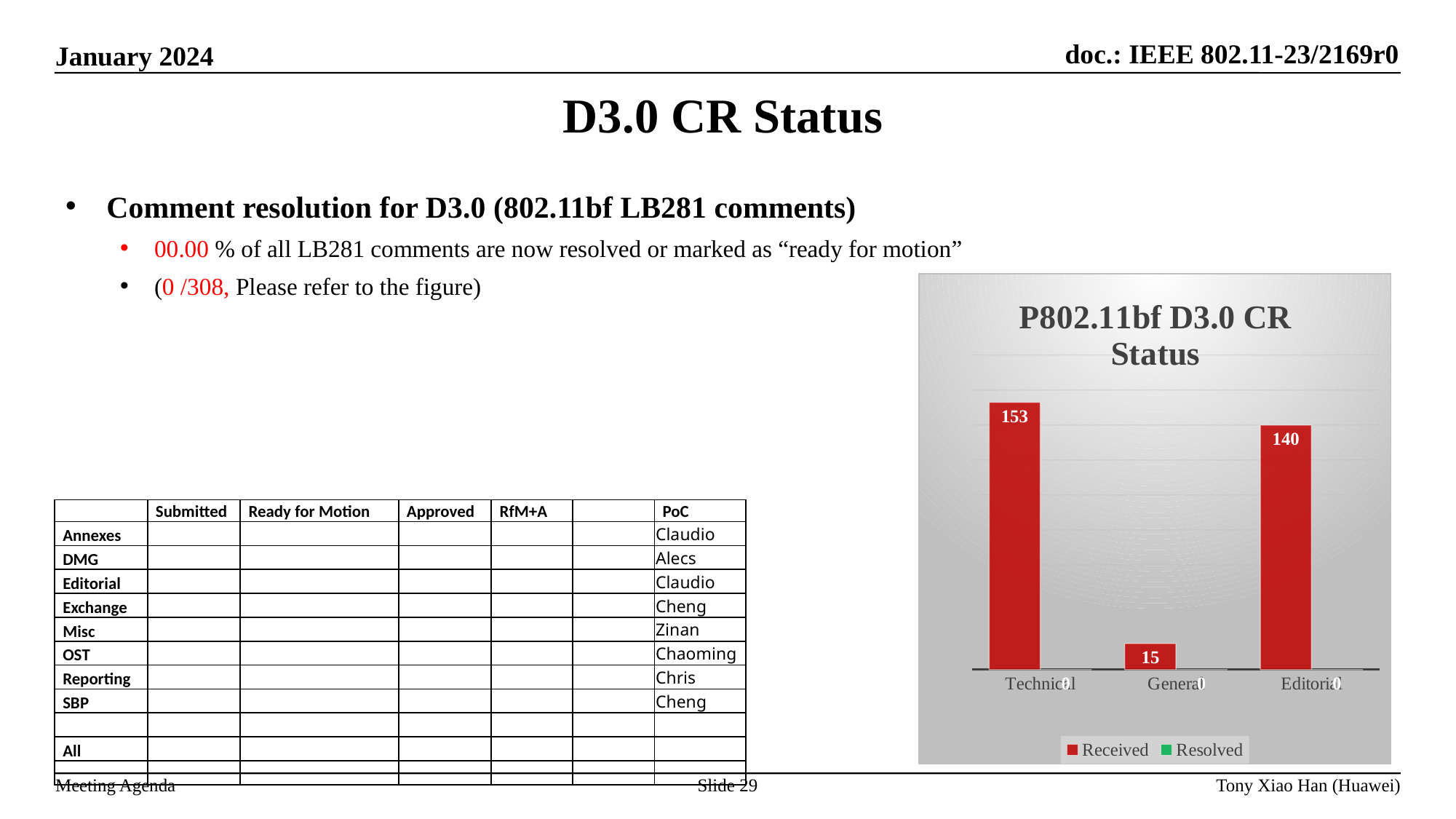
What is the Received value for Technical? 153 Which category has the highest Received value? Technical What type of chart is shown on the slide? bar chart What is the title of the chart? P802.11bf D3.0 CR Status How many series does the chart legend list? 2 What is the Received value for General? 15 What is the Received value for Editorial? 140 How many categories are shown on the x axis of the chart? 3 What is the difference between the Received values for Technical and Editorial? 13 Which series are listed in the chart legend? Received, Resolved Which is larger, the Received value for General or for Editorial? Editorial Which category has the lowest Received value? General